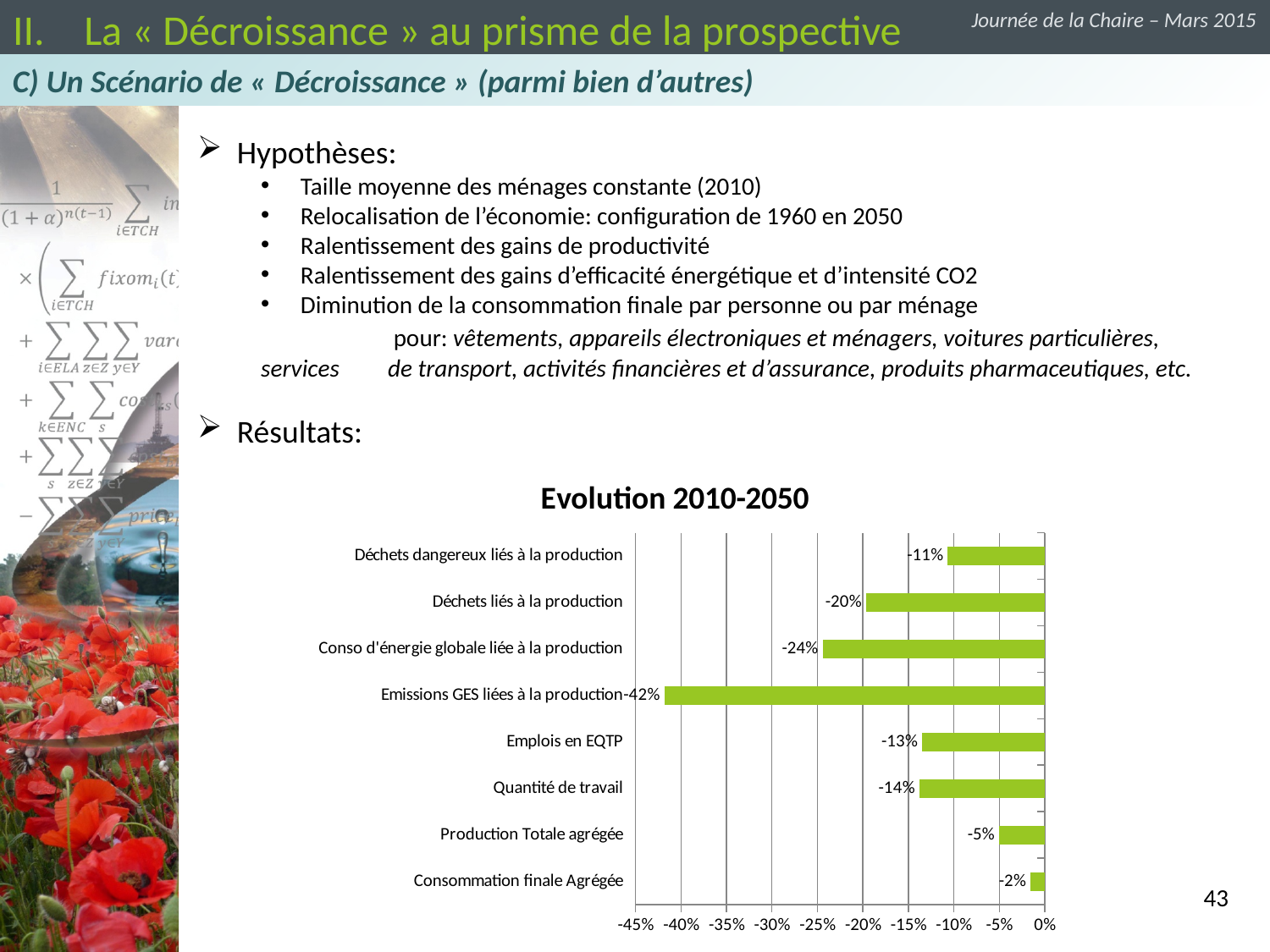
What is the value for Emissions GES liées à la production in the Evolution 2010-2050 chart? -42% Which category shows the smallest decrease in the Evolution 2010-2050 chart? Consommation finale Agrégée What type of chart is the Evolution 2010-2050 chart? Bar chart What colour are the bars in the Evolution 2010-2050 chart? Green What is the value for Production Totale agrégée in the Evolution 2010-2050 chart? -5% What is the title of the chart on the slide? Evolution 2010-2050 How many categories are shown in the Evolution 2010-2050 chart? 8 What is the value for Quantité de travail in the Evolution 2010-2050 chart? -14% Which has a larger decrease in the Evolution 2010-2050 chart: Emplois en EQTP or Déchets dangereux liés à la production? Emplois en EQTP What is the difference between the values for Conso d'énergie globale liée à la production and Déchets liés à la production in the Evolution 2010-2050 chart? 4 percentage points Which category shows the largest decrease in the Evolution 2010-2050 chart? Emissions GES liées à la production What is the value for Déchets liés à la production in the Evolution 2010-2050 chart? -20%